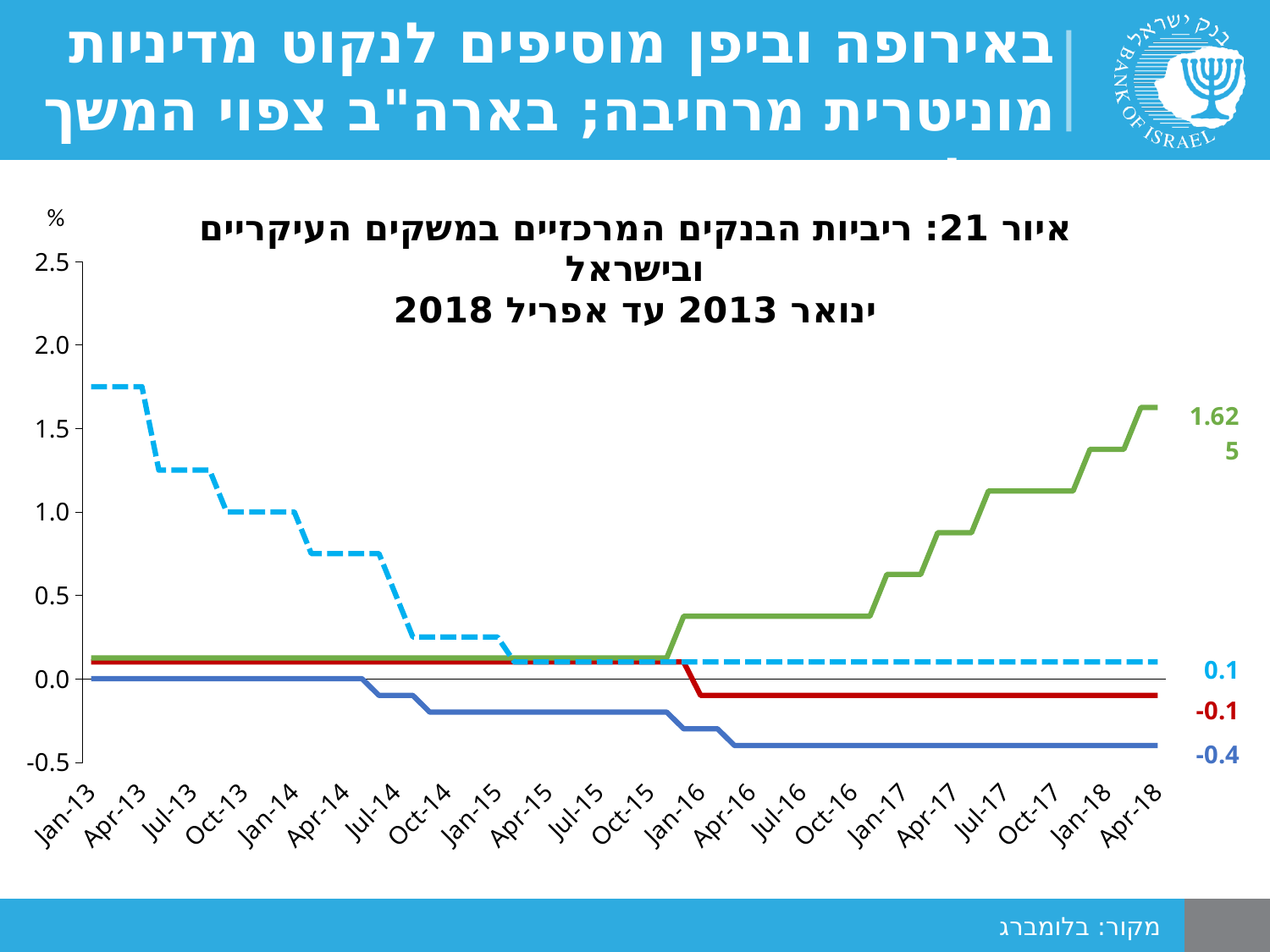
Is the value of the dashed light blue line at Jan-13 greater or less than 1.5? greater What is the difference between the end values of the green line (1.625) and the solid dark blue line (-0.4)? 2.025 Which line has the lowest value at the end of the period (Apr-18)? the solid dark blue line What is the value labelled at the end of the green line (Apr-18)? 1.625 What is the value labelled at the end of the red line (Apr-18)? -0.1 Does the green line rise or fall over the period from Jan-13 to Apr-18? rises What unit is shown on the y axis of the chart? % How many lines are plotted on the chart? 4 Which line has the highest value at the end of the period (Apr-18)? the green line What kind of chart is shown on the slide? line chart What is the value labelled at the end of the solid dark blue line (Apr-18)? -0.4 What is the value labelled at the end of the dashed light blue line (Apr-18)? 0.1